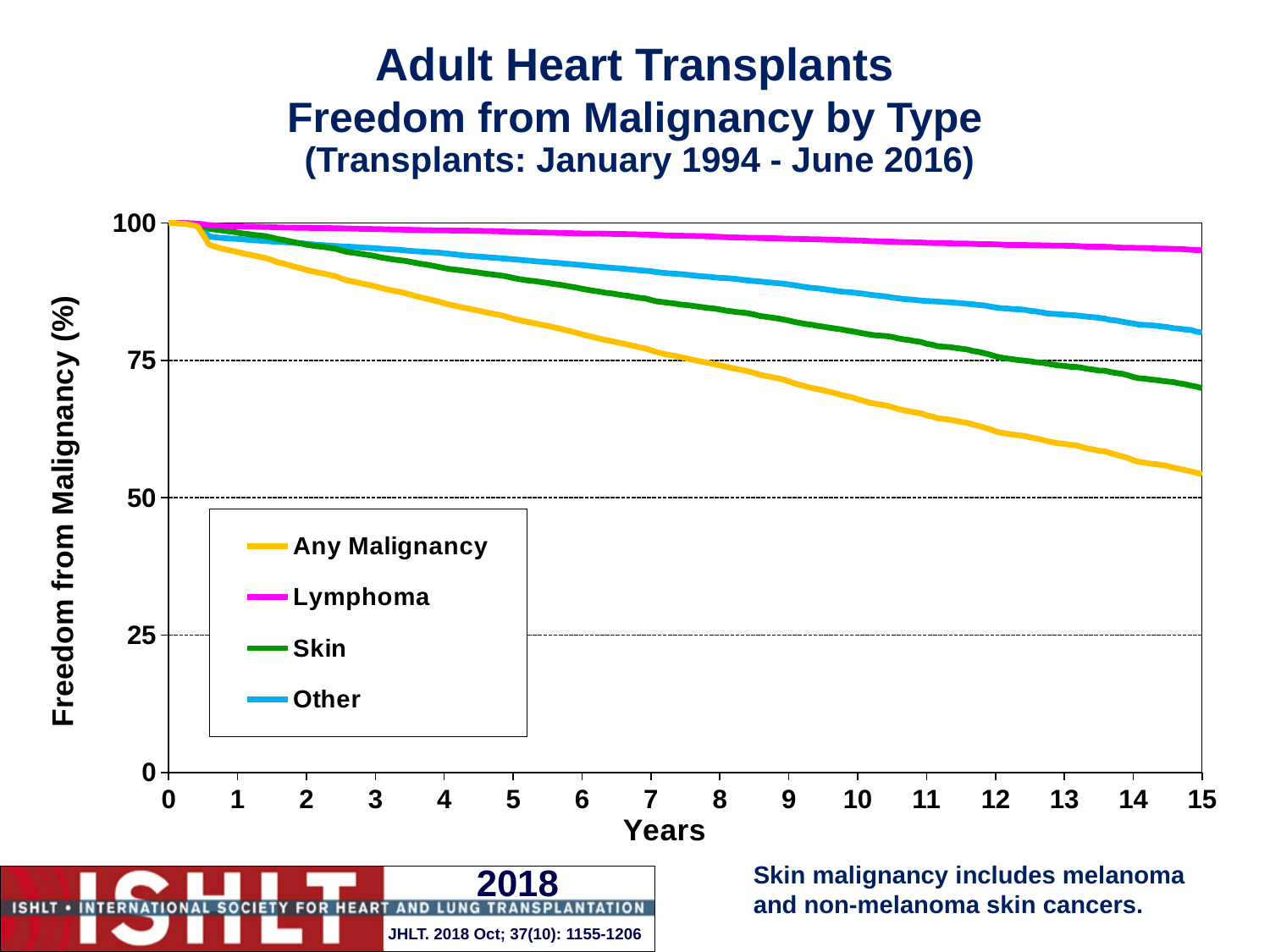
Is the value for Skin at 15 years greater or less than 75? less What kind of chart is shown on the slide? Line chart Is the value for Any Malignancy at 15 years greater or less than 50? greater How many series does the legend list? 4 Which colour is used for the Skin series? Green Do the freedom from malignancy values rise or fall as years increase? Fall What is the label of the y axis? Freedom from Malignancy (%) Is the value for Any Malignancy at 10 years greater or less than 75? less Which series has the highest freedom from malignancy at 15 years? Lymphoma At 10 years, which is higher: Other or Any Malignancy? Other Which series has the lowest freedom from malignancy at 15 years? Any Malignancy